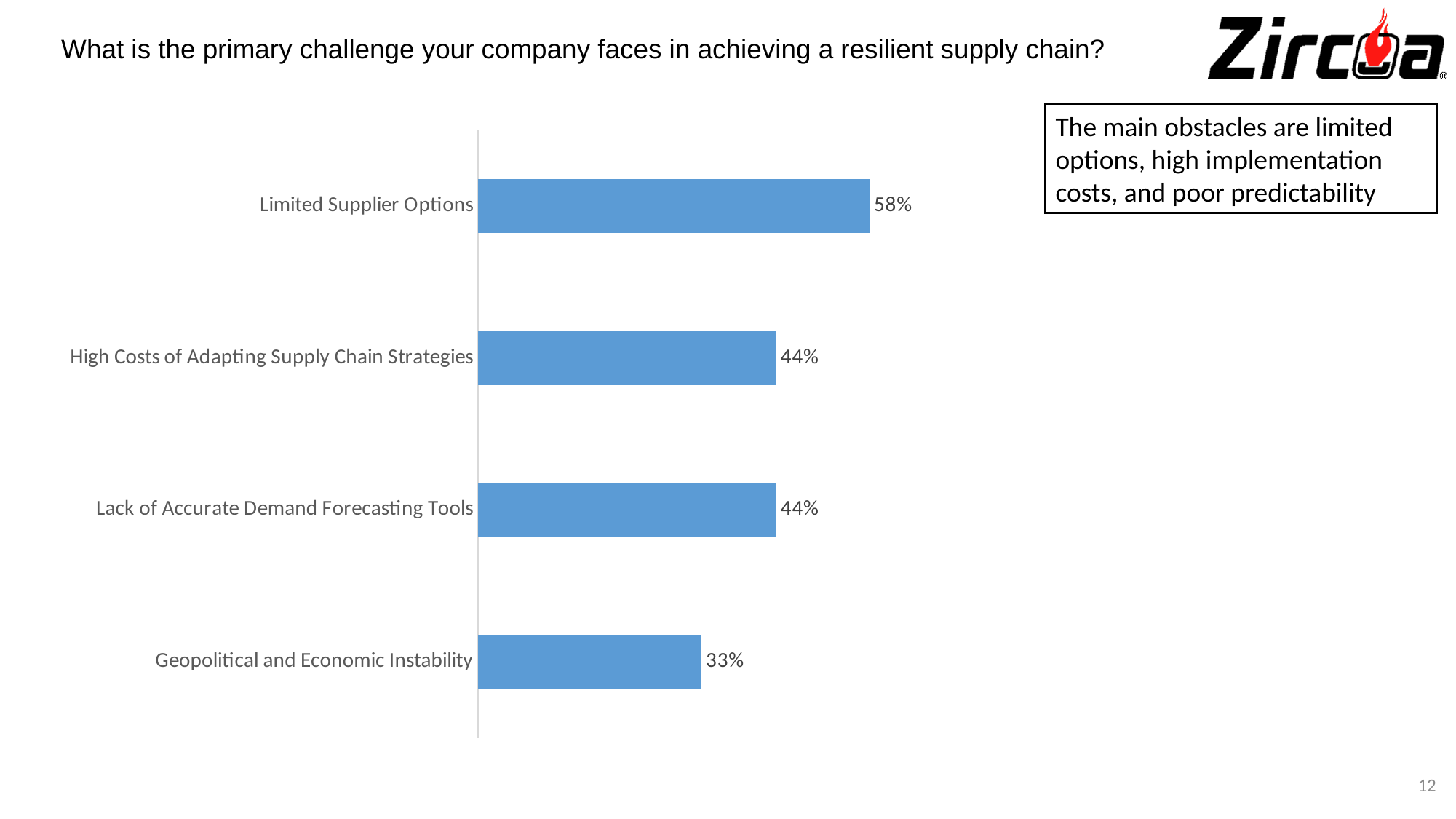
Which challenge has the lowest percentage? Geopolitical and Economic Instability What kind of chart is shown on the slide? Bar chart What percentage is shown for Limited Supplier Options? 58% What percentage is shown for Geopolitical and Economic Instability? 33% What percentage is shown for Lack of Accurate Demand Forecasting Tools? 44% What is the difference in percentage points between Limited Supplier Options and High Costs of Adapting Supply Chain Strategies? 14 What is the difference in percentage points between Limited Supplier Options and Geopolitical and Economic Instability? 25 Which challenge has the highest percentage? Limited Supplier Options Which is larger: the value for Lack of Accurate Demand Forecasting Tools or the value for Geopolitical and Economic Instability? Lack of Accurate Demand Forecasting Tools What colour are the bars in the chart? Blue How many challenge categories are shown in the chart? 4 What percentage is shown for High Costs of Adapting Supply Chain Strategies? 44%